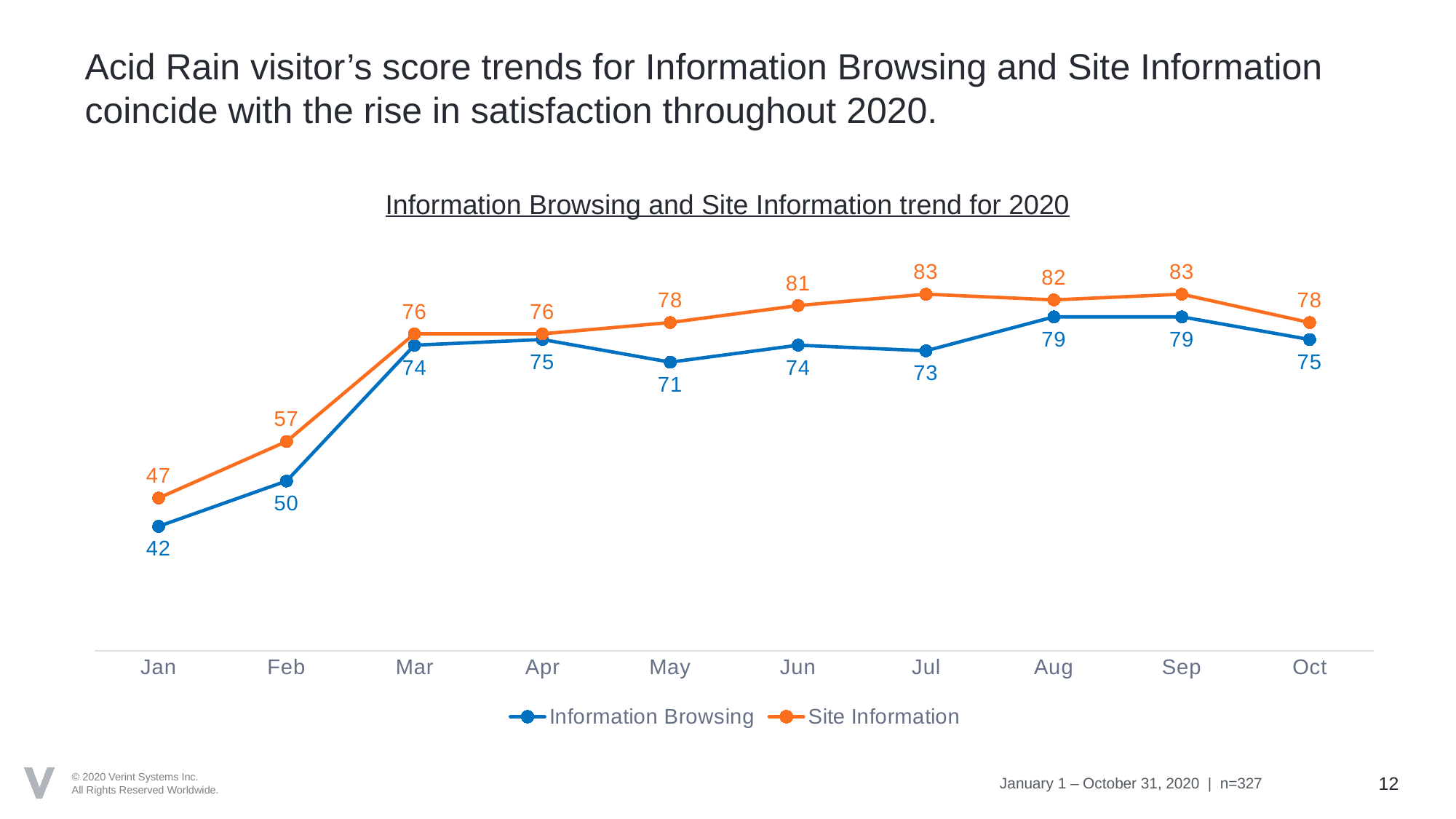
In which month is the Site Information score lowest? Jan Which series has the higher score in Jun, Information Browsing or Site Information? Site Information What is the difference between the Information Browsing scores for Feb and Mar? 24 What is the Information Browsing score for Jan? 42 What is the Site Information score for Jul? 83 What is the Information Browsing score for May? 71 How many series does the legend list? 2 How many months are plotted on the x axis? 10 In which month is the Information Browsing score lowest? Jan What is the difference between the Site Information and Information Browsing scores in May? 7 What is the title of the chart? Information Browsing and Site Information trend for 2020 What kind of chart is shown on the slide? Line chart